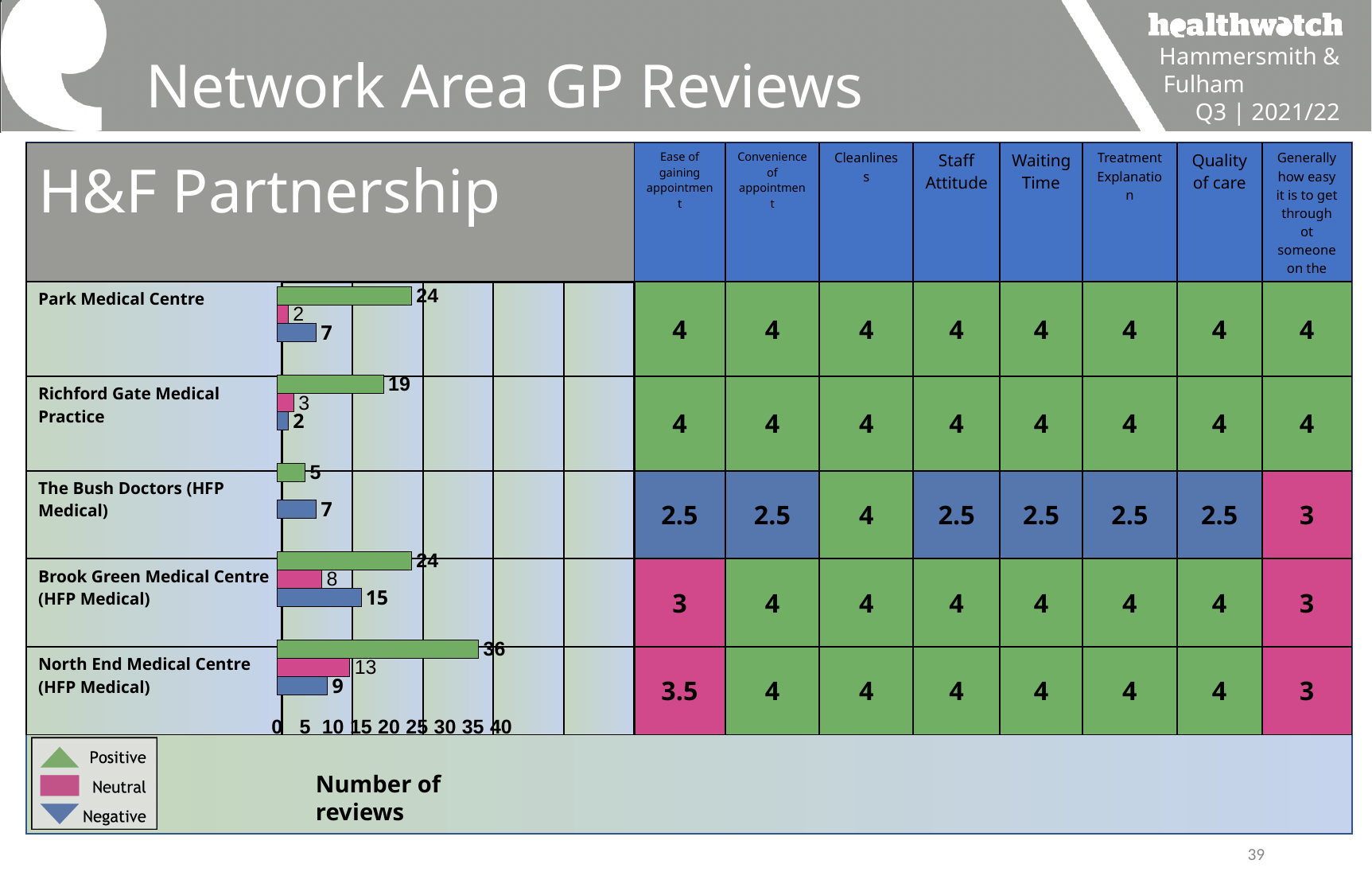
How many neutral reviews does Brook Green Medical Centre (HFP Medical) have? 8 Which colour represents Neutral reviews in the legend? pink How many practices are shown in the reviews chart? 5 What is the total number of reviews for Park Medical Centre across positive, neutral and negative? 33 How many series does the legend of the reviews chart list? 3 How many positive reviews does North End Medical Centre (HFP Medical) have? 36 Which practice has the fewest positive reviews? The Bush Doctors (HFP Medical) What kind of chart shows the number of reviews for each practice? bar chart What is the difference between the positive and negative reviews for Brook Green Medical Centre (HFP Medical)? 9 How many negative reviews does Park Medical Centre have? 7 Which has more negative reviews, Richford Gate Medical Practice or North End Medical Centre (HFP Medical)? North End Medical Centre (HFP Medical) Which practice has the most positive reviews? North End Medical Centre (HFP Medical)